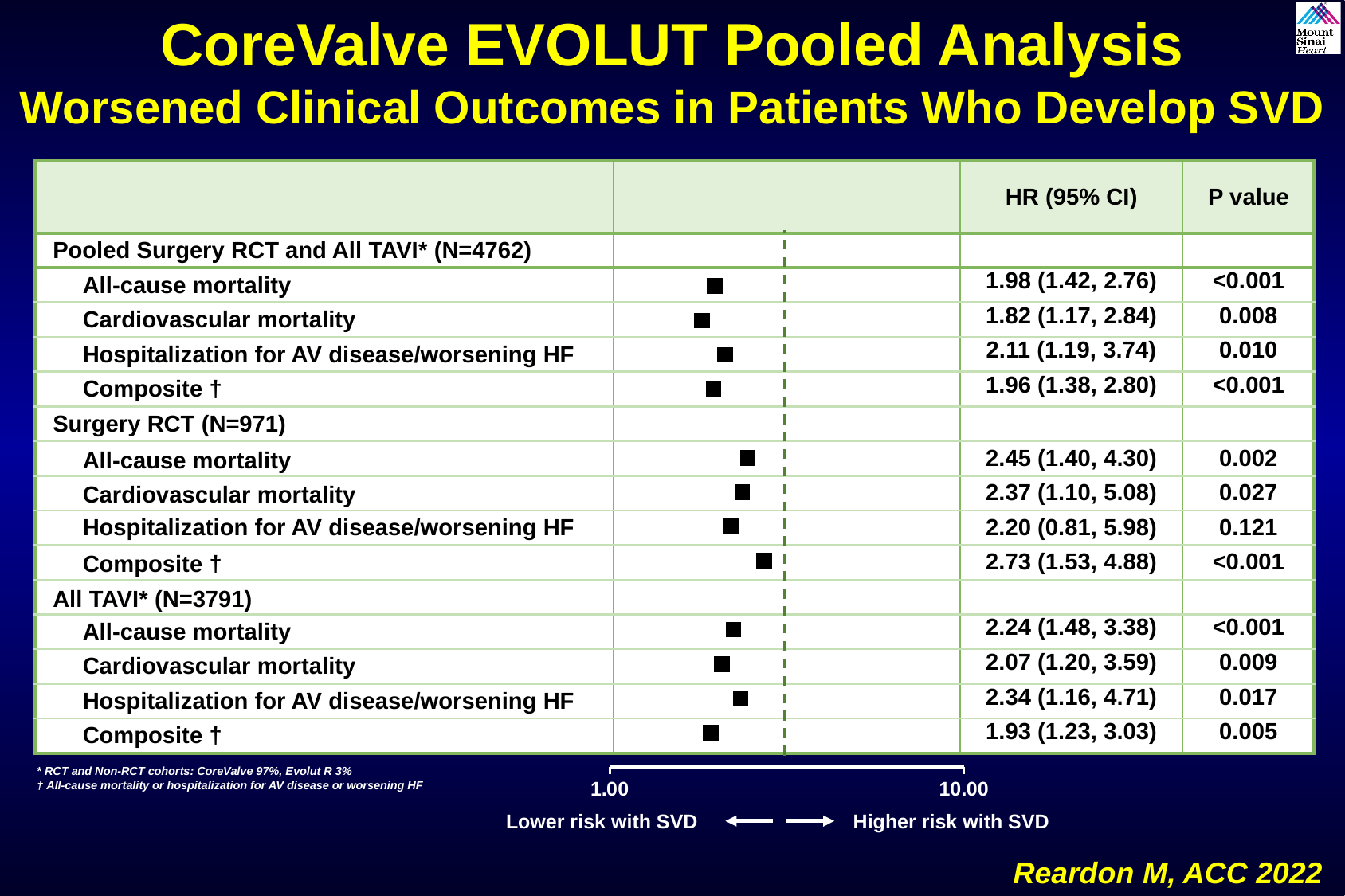
Which has a larger hazard ratio: hospitalization for AV disease/worsening HF in the All TAVI group or in the Pooled group? All TAVI (2.34) What is the difference between the all-cause mortality hazard ratio in the Surgery RCT group and in the Pooled group? 0.47 What is the hazard ratio for all-cause mortality in the Pooled Surgery RCT and All TAVI group? 1.98 Which outcome and group has the lowest hazard ratio on the slide? Cardiovascular mortality, Pooled Surgery RCT and All TAVI (1.82) Is the hazard ratio for the composite outcome in the All TAVI group greater or less than 1.00? greater How many outcome rows with hazard ratios are plotted on the slide? 12 What is the 95% confidence interval for the composite outcome in the Surgery RCT (N=971) group? (1.53, 4.88) Which outcome and group has the highest hazard ratio on the slide? Composite, Surgery RCT (2.73) What is the hazard ratio for cardiovascular mortality in the All TAVI (N=3791) group? 2.07 What kind of chart is shown on the slide? Forest plot What is the P value for hospitalization for AV disease/worsening HF in the Surgery RCT group? 0.121 What are the two axis tick values shown below the plot? 1.00 and 10.00